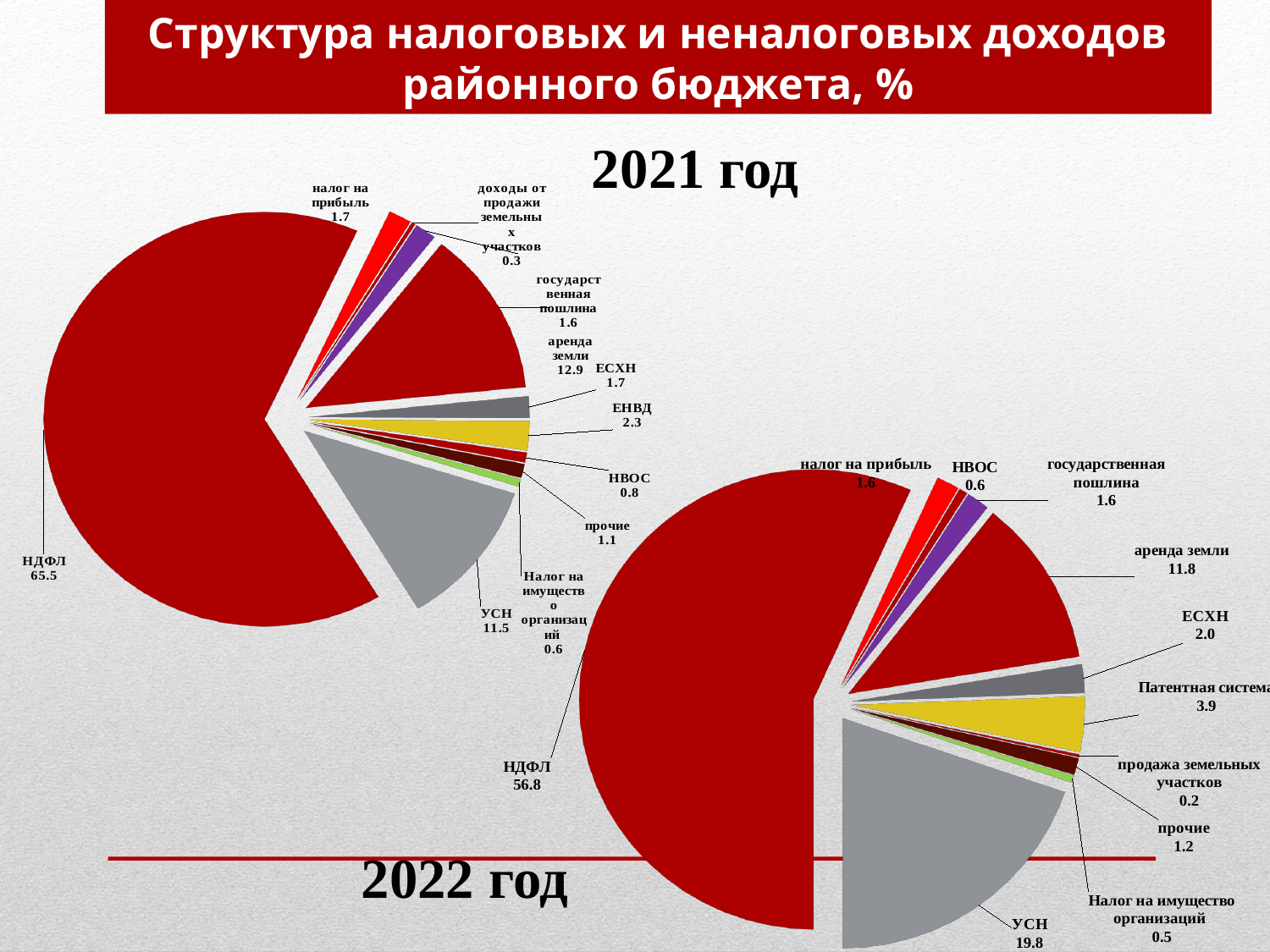
In the 2021 год pie chart, which category has the largest share? НДФЛ What is the difference between УСН in the 2022 год chart and УСН in the 2021 год chart? 8.3 In the 2022 год pie chart, what is the value for Патентная система? 3.9 What is the difference between the НДФЛ value in the 2021 год chart and the НДФЛ value in the 2022 год chart? 8.7 In the 2021 год pie chart, which is larger: ЕНВД or ЕСХН? ЕНВД In the 2022 год pie chart, which is larger: аренда земли or УСН? УСН In the 2022 год pie chart, which category has the smallest share? продажа земельных участков In the 2021 год pie chart, what is the value for НДФЛ? 65.5 How many slices does the 2022 год pie chart have? 11 In the 2021 год pie chart, what is the value for аренда земли? 12.9 What type of chart is used to show the 2021 год data? Pie chart In the 2022 год pie chart, what is the value for УСН? 19.8